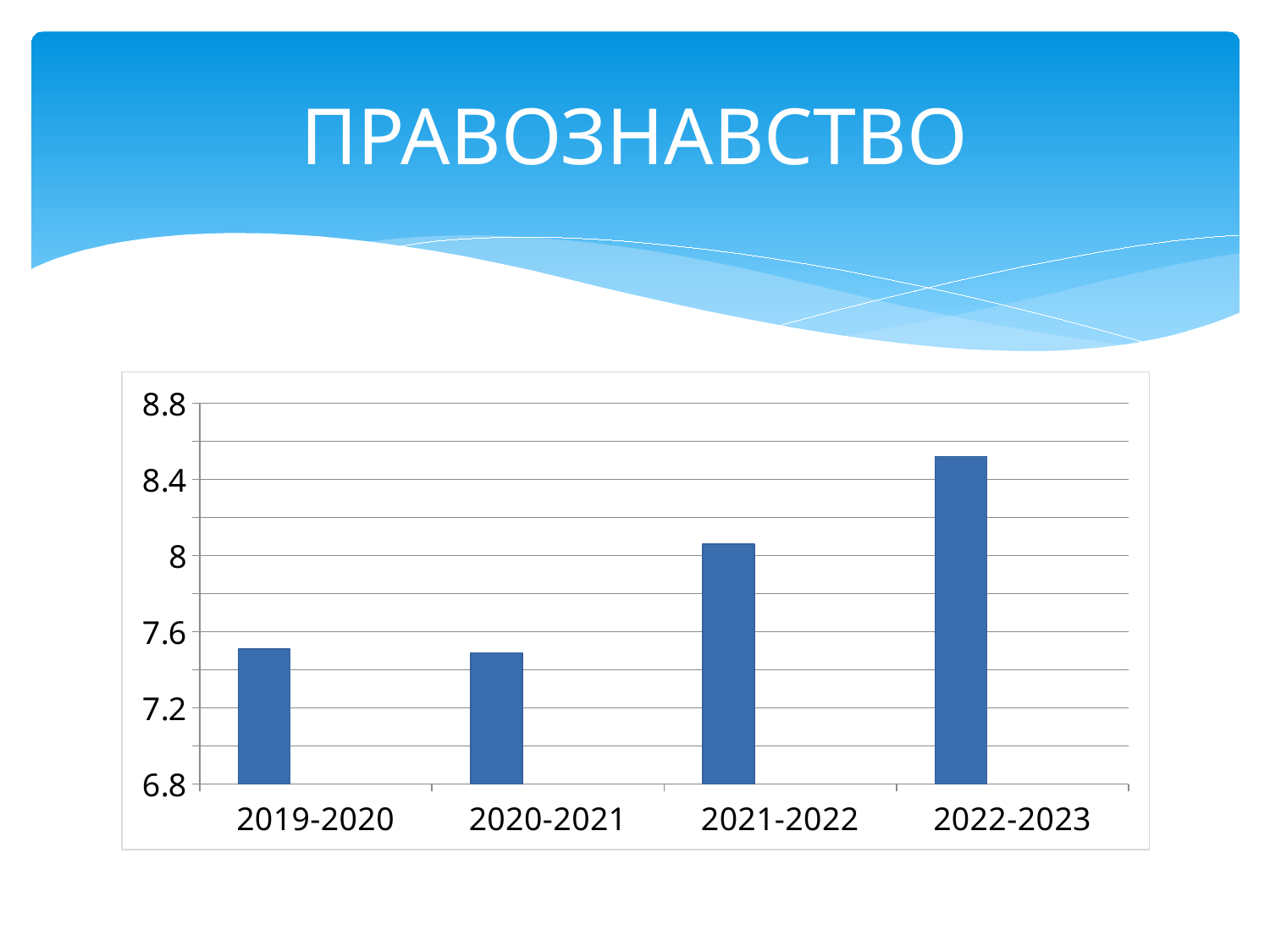
Which is larger, the value for 2021-2022 or the value for 2022-2023? 2022-2023 Which is larger, the value for 2019-2020 or the value for 2021-2022? 2021-2022 How many categories (school years) are shown on the x axis of the chart? 4 Is the value for 2020-2021 greater or less than 7.2? greater What kind of chart is shown on the slide? bar chart Which school year has the highest bar in the chart? 2022-2023 Do the values generally rise or fall from 2020-2021 to 2022-2023? rise Is the value for 2019-2020 greater or less than 7.6? less What is the title shown at the top of the slide above the chart? ПРАВОЗНАВСТВО Is the value for 2021-2022 greater or less than 8? greater